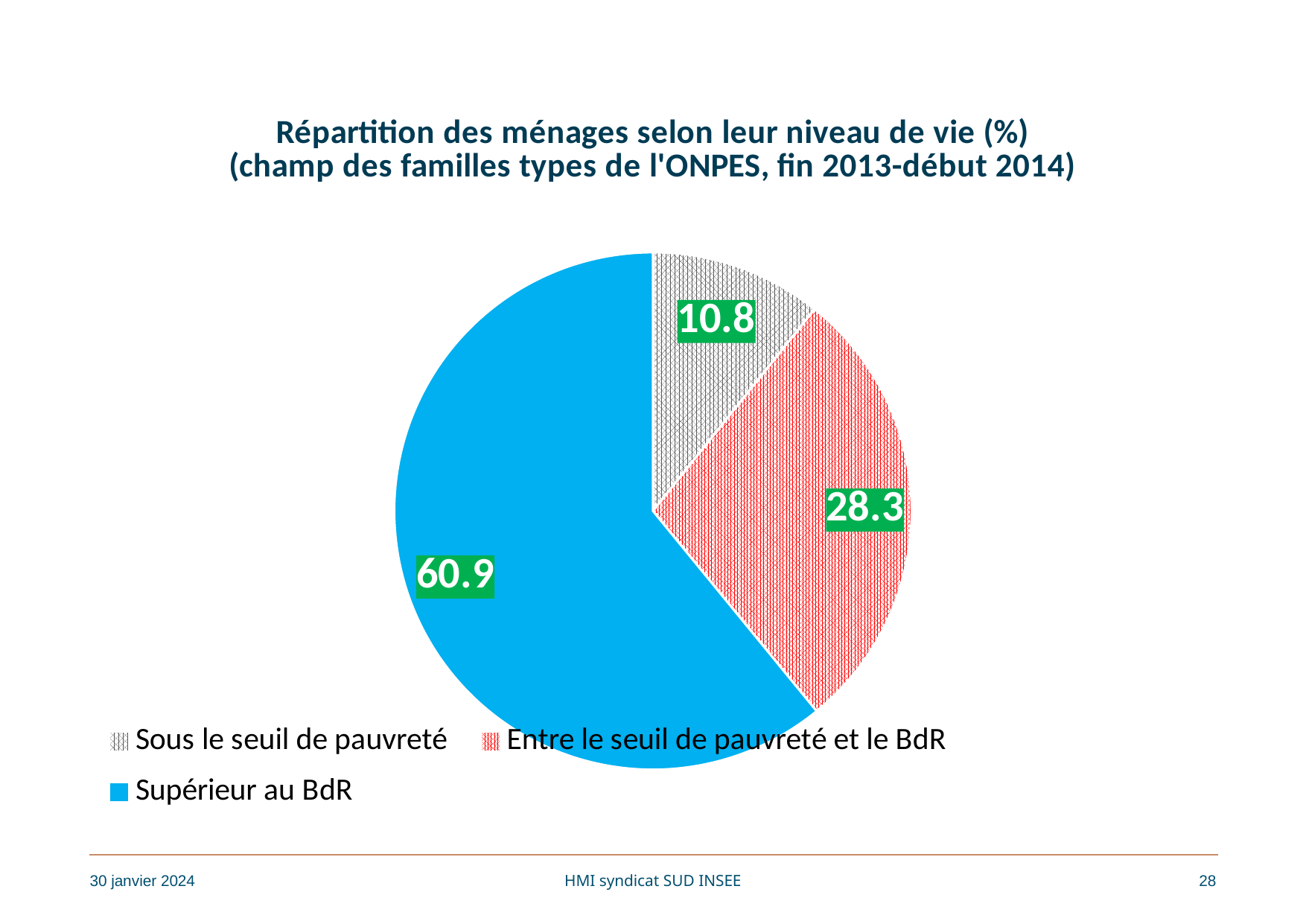
What is the title of the chart? Répartition des ménages selon leur niveau de vie (%) (champ des familles types de l'ONPES, fin 2013-début 2014) How many slices does the pie chart have? 3 Which category has the smallest slice of the pie? Sous le seuil de pauvreté What is the value for "Supérieur au BdR"? 60.9 What is the difference between the values for "Supérieur au BdR" and "Entre le seuil de pauvreté et le BdR"? 32.6 What is the value for "Sous le seuil de pauvreté"? 10.8 What is the value for "Entre le seuil de pauvreté et le BdR"? 28.3 Which is larger: the value for "Sous le seuil de pauvreté" or the value for "Entre le seuil de pauvreté et le BdR"? Entre le seuil de pauvreté et le BdR What is the difference between the values for "Entre le seuil de pauvreté et le BdR" and "Sous le seuil de pauvreté"? 17.5 Which category is shown in solid blue? Supérieur au BdR Which category has the largest slice of the pie? Supérieur au BdR What kind of chart is shown on the slide? pie chart